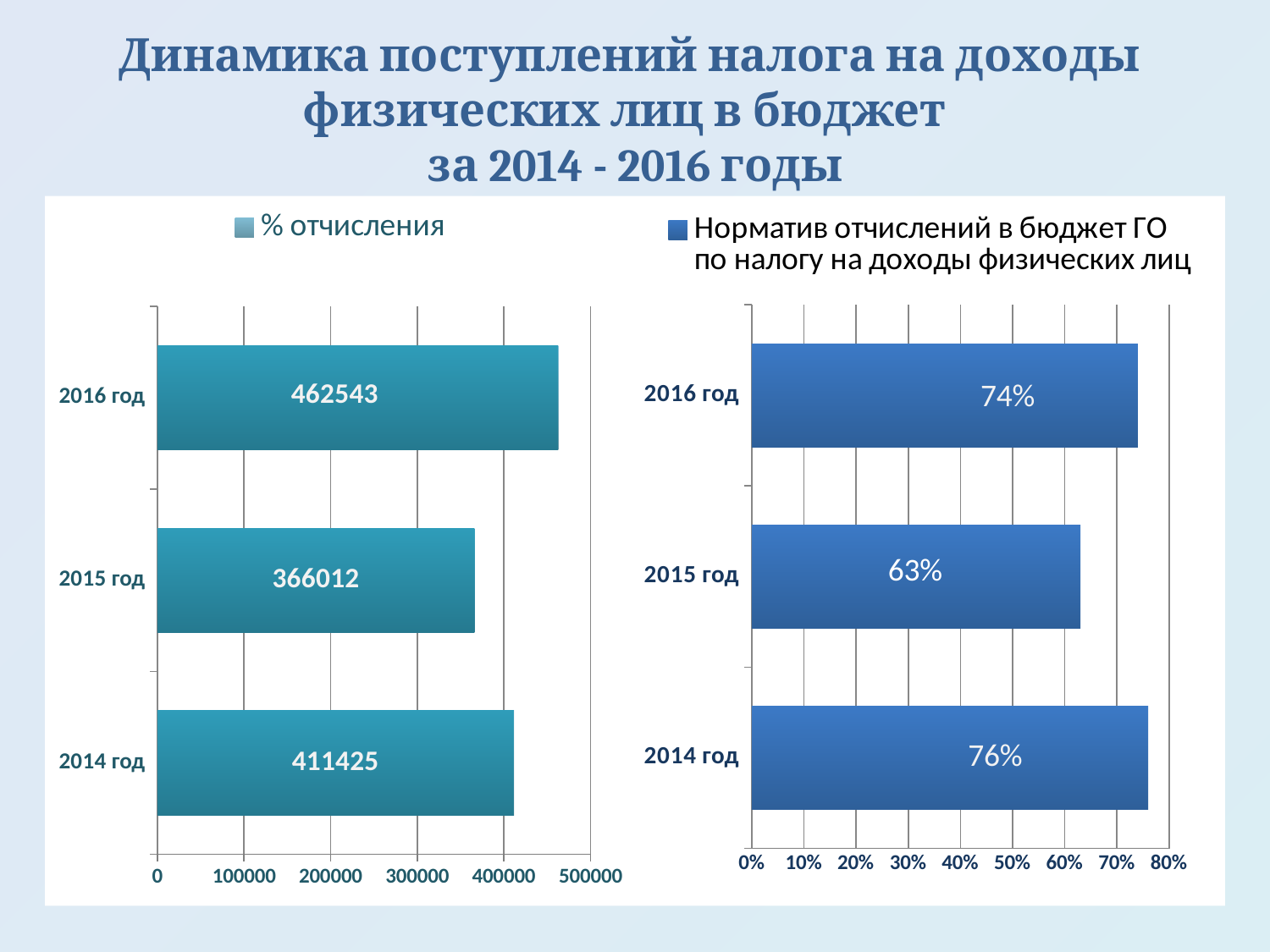
In the left chart (% отчисления), is the value for 2015 год greater or less than 400000? less In the left chart (% отчисления), which year has the highest value? 2016 год In the right chart (Норматив отчислений в бюджет ГО), what is the difference between the values for 2014 год and 2016 год? 2% In the left chart (% отчисления), what is the difference between the values for 2016 год and 2014 год? 51118 What type of chart is the left chart (% отчисления)? bar chart In the right chart (Норматив отчислений в бюджет ГО), which year has the lowest value? 2015 год In the left chart (% отчисления), what is the value for 2016 год? 462543 In the left chart (% отчисления), which year has the lowest value? 2015 год In the right chart (Норматив отчислений в бюджет ГО), what is the value for 2014 год? 76% In the left chart (% отчисления), what is the value for 2015 год? 366012 In the right chart (Норматив отчислений в бюджет ГО), what is the value for 2015 год? 63% How many categories (years) are shown in the right chart (Норматив отчислений в бюджет ГО)? 3